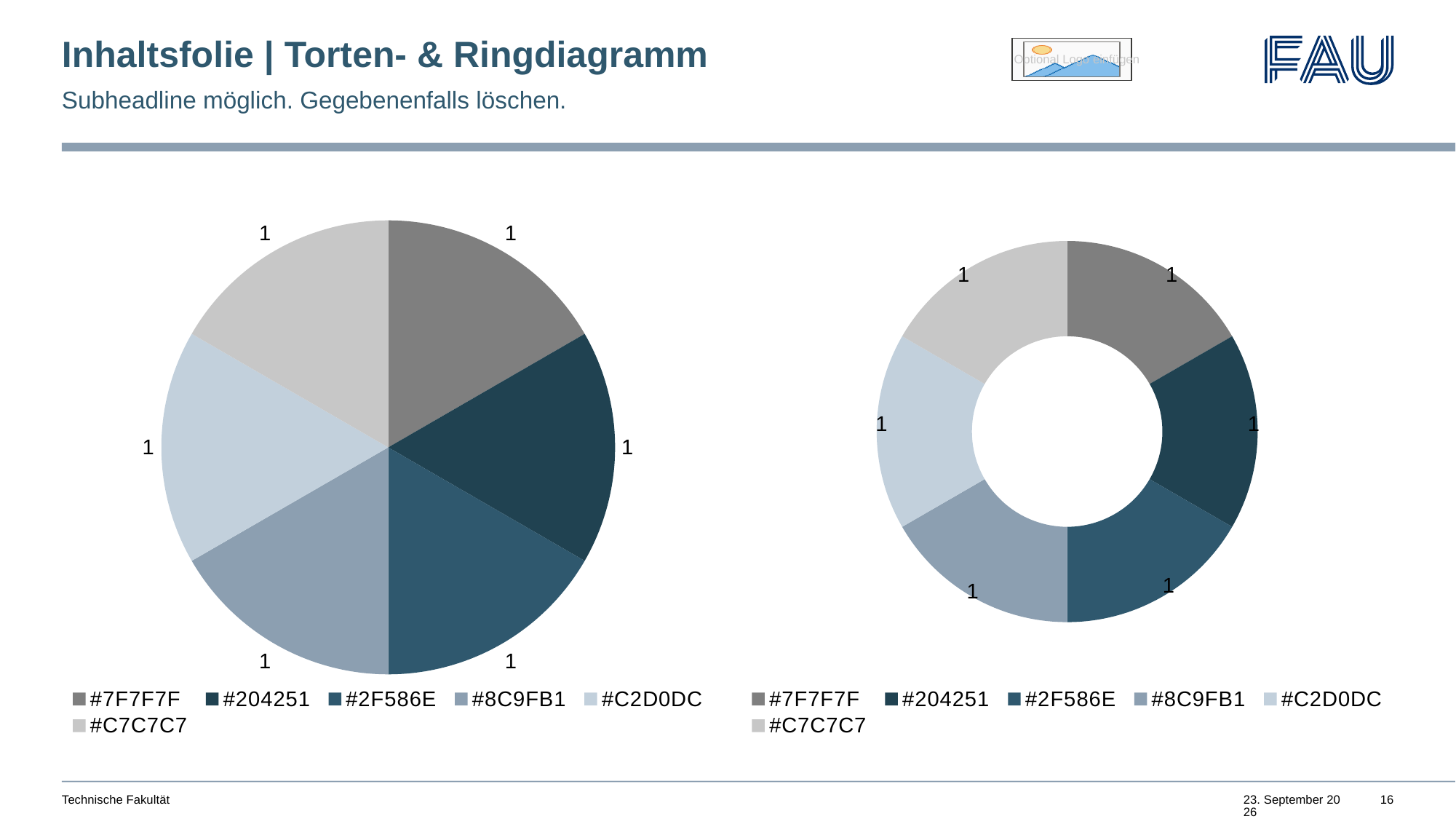
What kind of chart is the chart on the left of the slide? pie chart In the doughnut chart on the right, what is the last entry listed in the legend? #C7C7C7 In the doughnut chart on the right, what is the value of the #C7C7C7 segment? 1 In the pie chart on the left, how many slices are there? 6 In the pie chart on the left, what is the total of all slice values? 6 What kind of chart is the chart on the right of the slide? doughnut chart In the pie chart on the left, what is the first entry listed in the legend? #7F7F7F In the pie chart on the left, what is the value of the #204251 slice? 1 In the pie chart on the left, how many entries does the legend list? 6 In the doughnut chart on the right, how many entries does the legend list? 6 In the doughnut chart on the right, what is the total of all segment values? 6 In the doughnut chart on the right, how many segments are there? 6